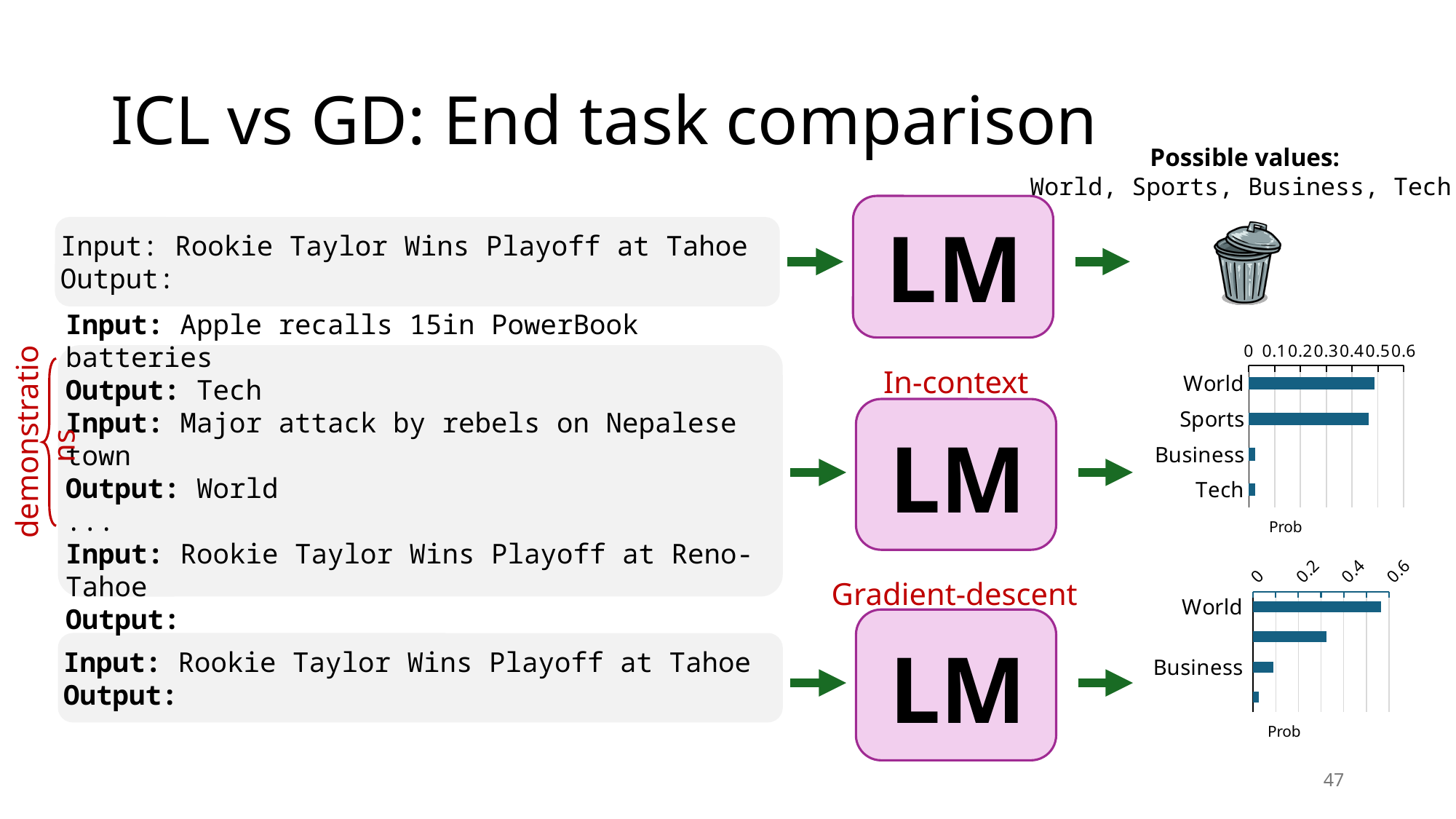
In the Gradient-descent chart, how many bars are plotted? 4 In the In-context chart, is the value for Business greater or less than 0.1? less In the In-context chart, is the value for Tech greater or less than 0.1? less In the In-context chart, how many categories are listed on the vertical axis? 4 In the In-context chart, is the value for Sports greater or less than 0.4? greater What is the x-axis label of the In-context chart? Prob In the In-context chart, which is larger, the value for World or the value for Business? World In the Gradient-descent chart, which labelled category has the highest value? World What kind of chart is the In-context chart on the right of the slide? bar chart